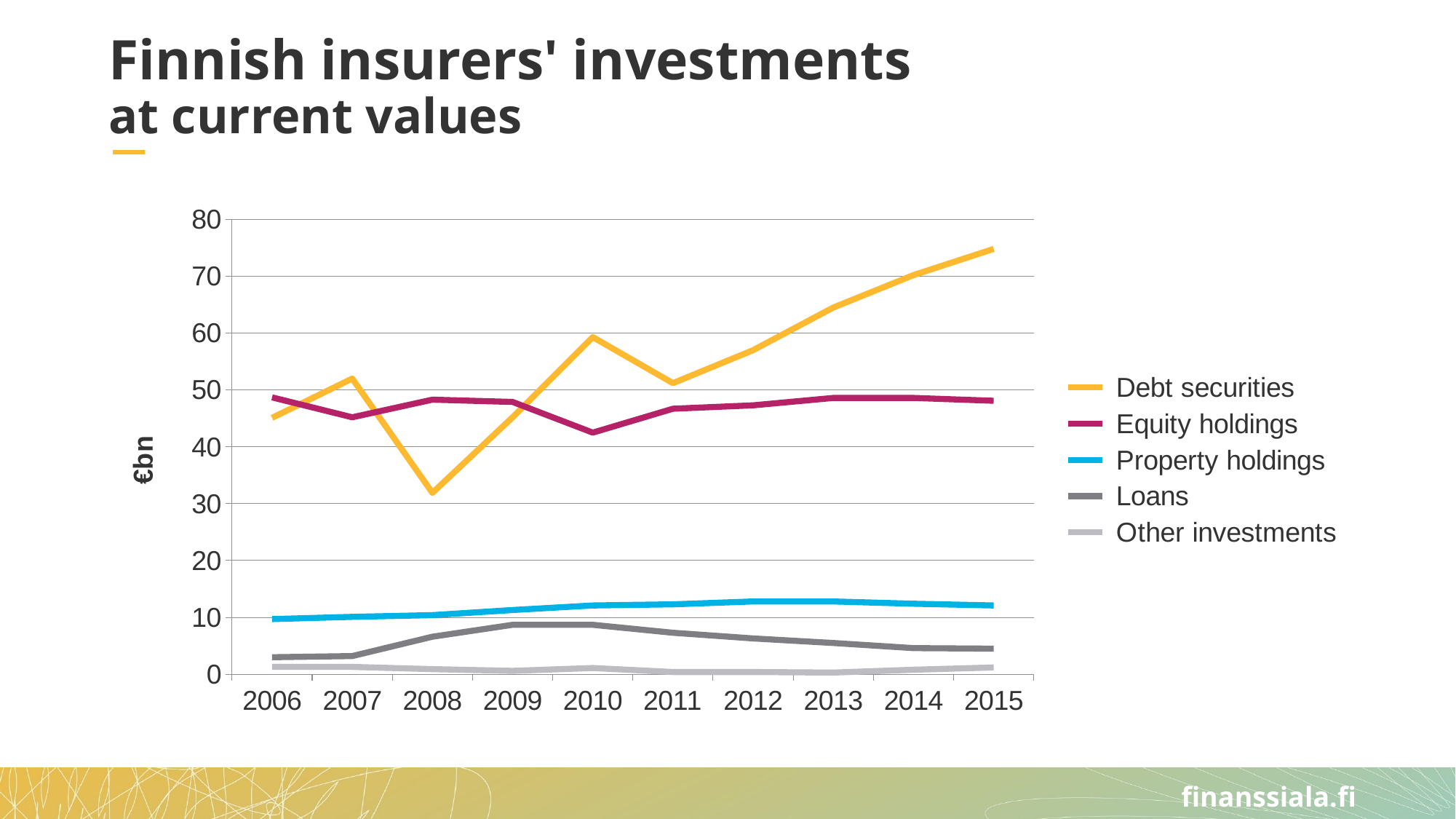
Do the Debt securities values rise or fall from 2011 to 2015? rise Is the value for Debt securities in 2015 greater or less than 70? greater How many series does the legend list? 5 In 2010, which is larger: Debt securities or Equity holdings? Debt securities In which year is the Debt securities value lowest? 2008 Which series has the highest value in 2015? Debt securities What kind of chart is shown on the slide? line chart Is the value for Debt securities in 2008 greater or less than 40? less In which year is the Debt securities value highest? 2015 Which series has the lowest values across the whole chart? Other investments How many years are shown on the x axis? 10 Is the value for Loans in 2009 greater or less than 10? less